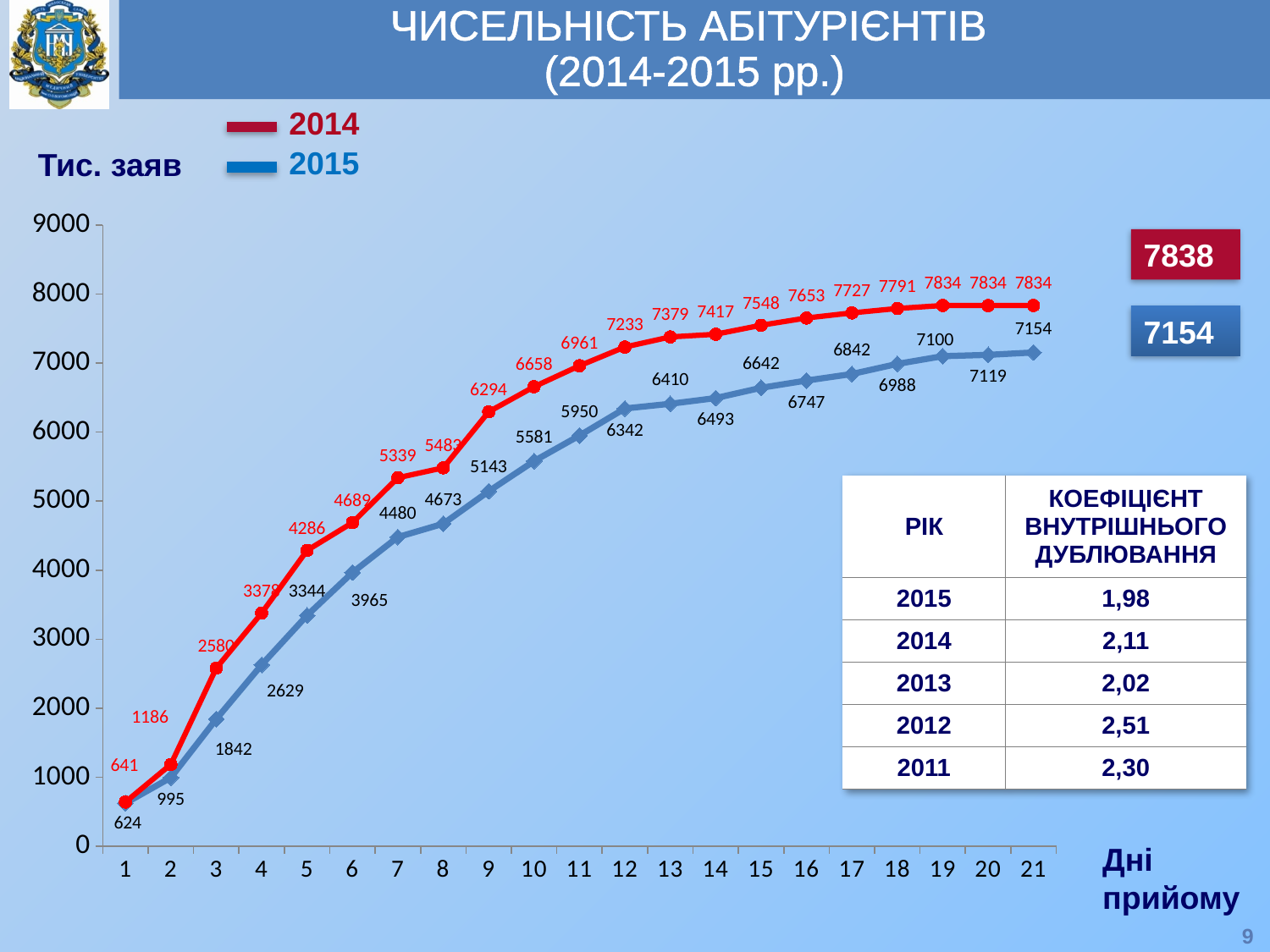
What is the value for 2014 on day 1? 641 What is the value for 2015 on day 15? 6642 How many series does the chart legend list? 2 On day 10, which series has the larger value, 2014 or 2015? 2014 What is the difference between the 2014 and 2015 values on day 21? 680 What is the value for 2014 on day 12? 7233 What colour is the line for the 2014 series? red What kind of chart is shown on the slide? line chart Do the values for the 2015 series rise or fall along the x axis? rise Is the value for 2015 on day 3 greater or less than 2000? less How many admission days (points) are plotted along the x axis? 21 What is the value for 2015 on day 21? 7154